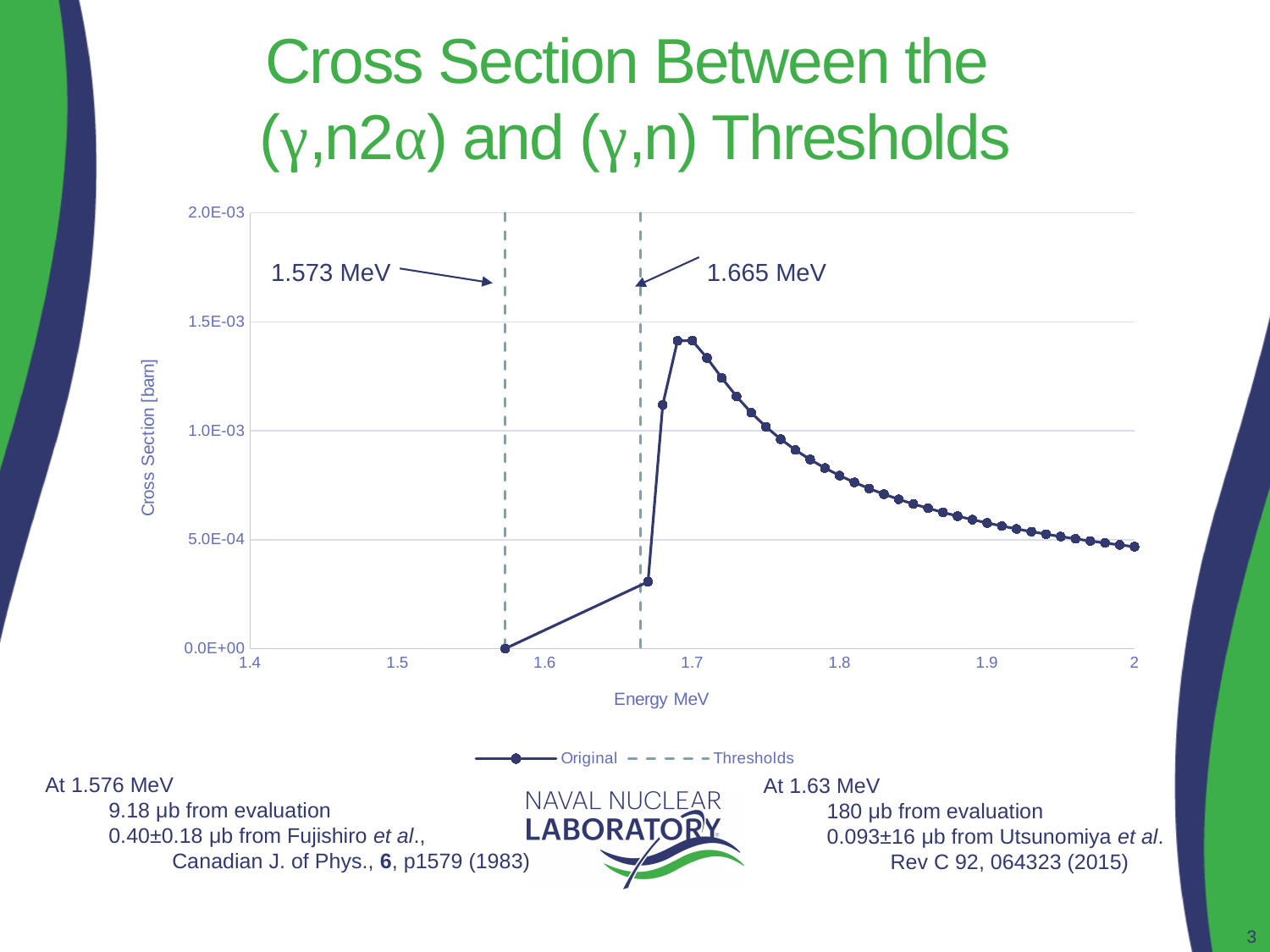
What is the title of the chart's y axis? Cross Section [barn] Is the peak value of the Original series greater or less than 1.0E-03? greater Is the peak value of the Original series greater or less than 1.5E-03? less What is the cross section of the Original series at the 1.573 MeV threshold? 0.0E+00 What kind of chart is shown on the slide? line chart At what energy is the left dashed threshold line drawn? 1.573 MeV Is the value of the Original series at 1.8 MeV greater or less than 1.0E-03? less What are the two entries in the chart legend? Original and Thresholds What is the difference in energy between the two threshold lines, 1.665 MeV and 1.573 MeV? 0.092 MeV At what energy is the right dashed threshold line drawn? 1.665 MeV How many series does the chart legend list? 2 Between 1.7 MeV and 2 MeV, do the values of the Original series rise or fall as energy increases? fall